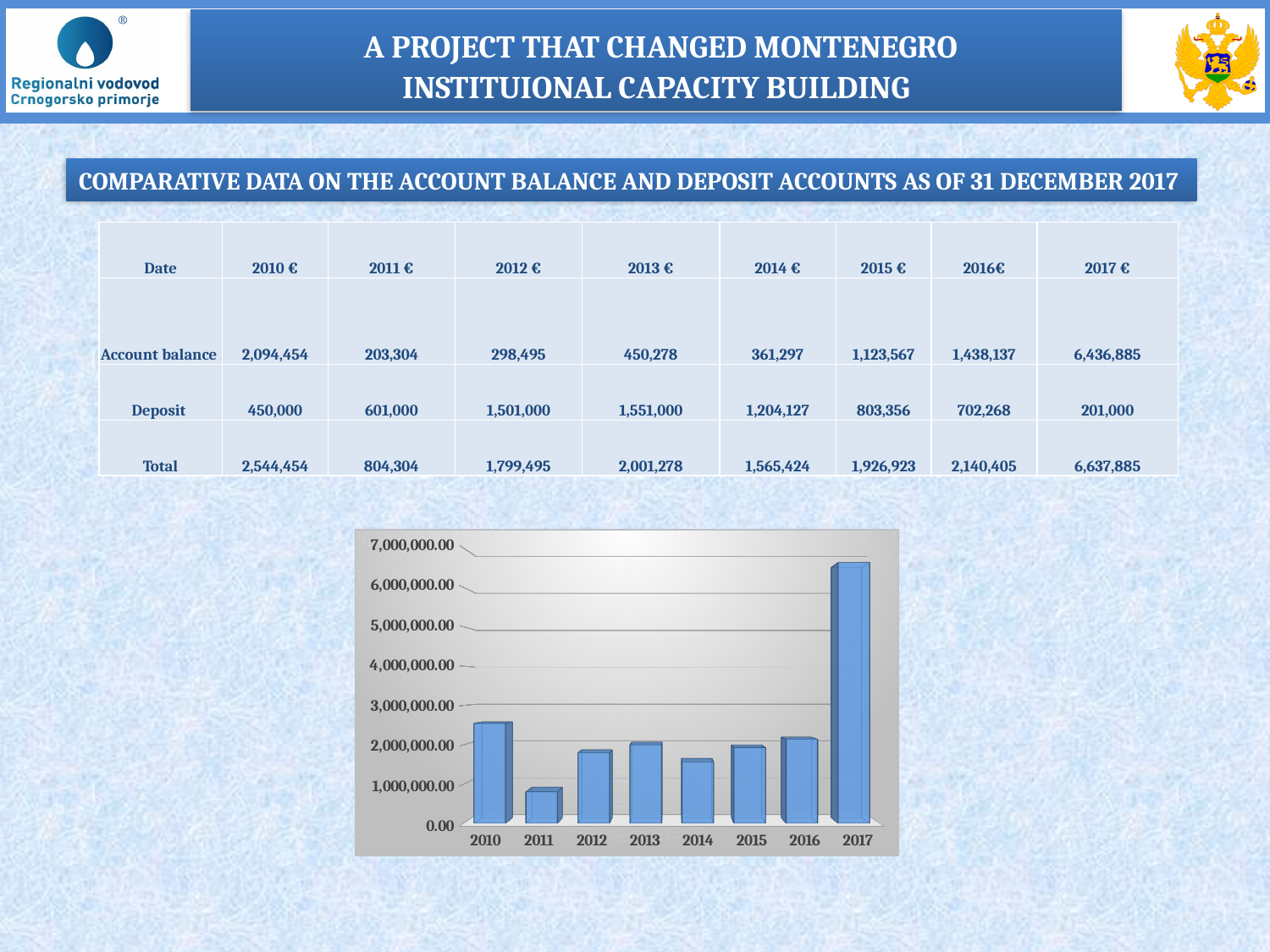
What is the highest value labelled on the vertical axis of the bar chart? 7,000,000.00 Is the value for 2011 in the bar chart greater or less than 1,000,000.00? less What kind of chart is shown on the slide? bar chart Is the value for 2017 in the bar chart greater or less than 6,000,000.00? greater In the bar chart, which is larger, the value for 2010 or the value for 2011? 2010 Is the value for 2014 in the bar chart greater or less than 2,000,000.00? less Do the bars rise or fall from 2014 to 2017 in the chart? rise How many years are plotted on the x axis of the bar chart? 8 Which year has the shortest bar in the chart? 2011 Which year has the tallest bar in the chart? 2017 In the bar chart, which is larger, the value for 2012 or the value for 2014? 2012